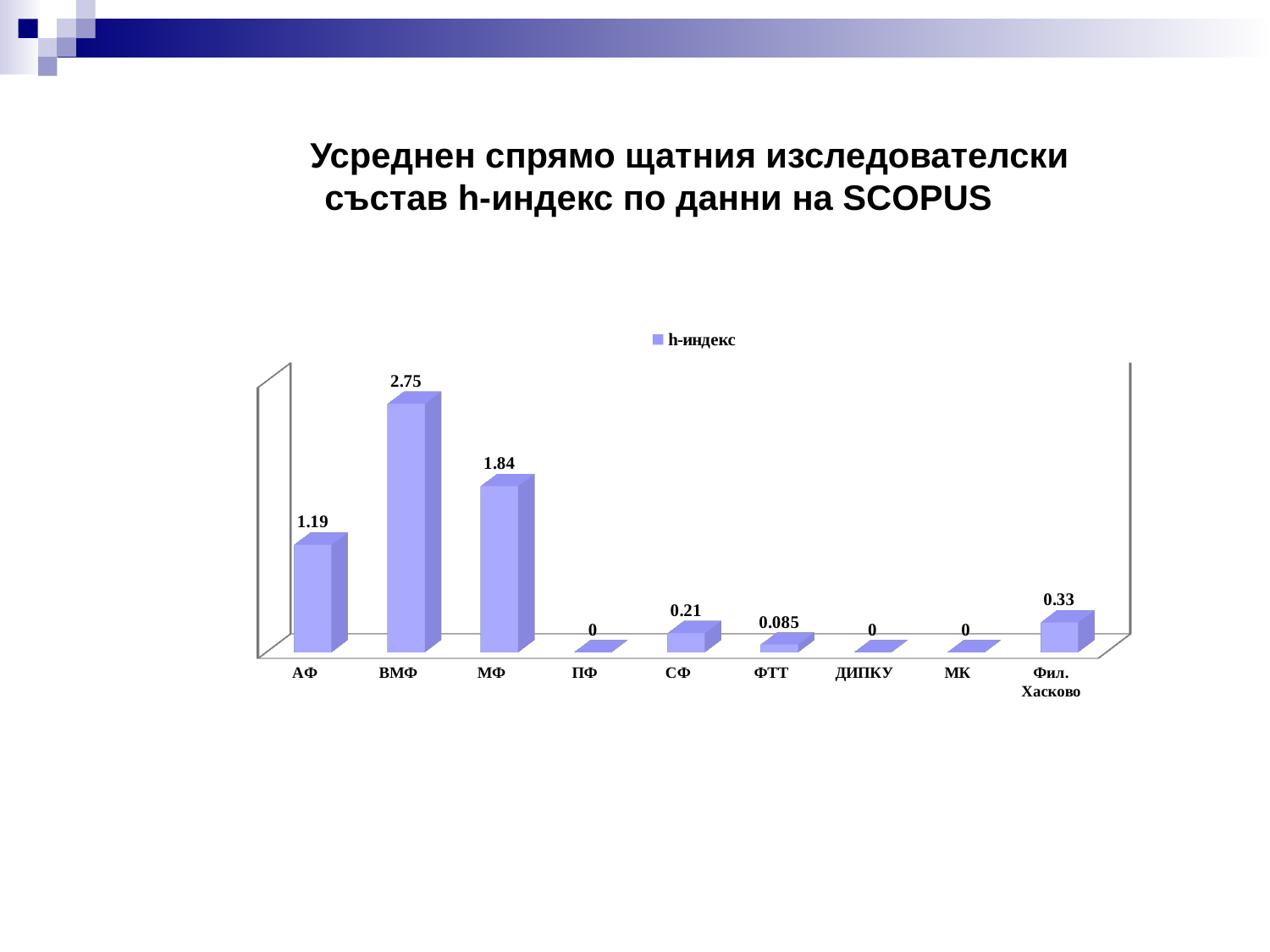
How many series does the legend list? 1 What is the h-индекс value for Фил. Хасково? 0.33 What is the h-индекс value for ФТТ? 0.085 What is the h-индекс value for АФ? 1.19 Which category has the highest h-индекс? ВМФ What kind of chart is shown on the slide? Bar chart How many categories are shown on the x axis? 9 What is the h-индекс value for ВМФ? 2.75 How many categories have an h-индекс value of 0? 3 What is the difference between the h-индекс values for ВМФ and МФ? 0.91 Which has a larger h-индекс, МФ or АФ? МФ What is the legend entry of the chart? h-индекс